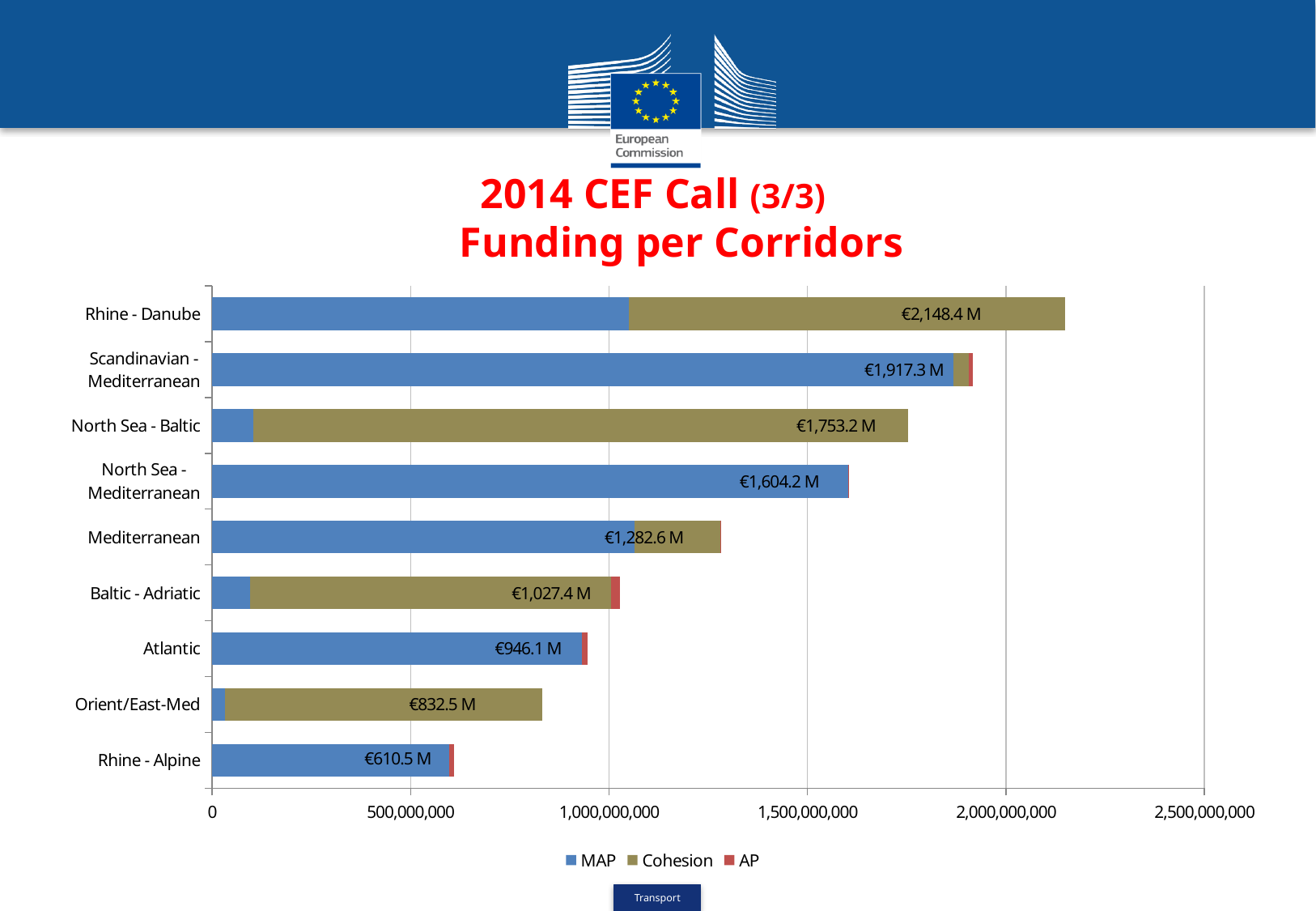
What is the total funding shown for the Rhine - Danube corridor? €2,148.4 M What is the total funding shown for the North Sea - Baltic corridor? €1,753.2 M How many series does the legend list? 3 What is the difference between the total funding for Atlantic and Orient/East-Med? €113.6 M What kind of chart is shown on the slide? Stacked bar chart Which corridor has the lowest total funding? Rhine - Alpine Which corridor has more total funding, Mediterranean or Baltic - Adriatic? Mediterranean Is the total funding for the Rhine - Alpine corridor greater or less than 1,000,000,000? less What is the total funding shown for the Orient/East-Med corridor? €832.5 M Which corridor has the highest total funding? Rhine - Danube What is the difference between the total funding for Rhine - Danube and Rhine - Alpine? €1,537.9 M How many corridors are shown in the chart? 9